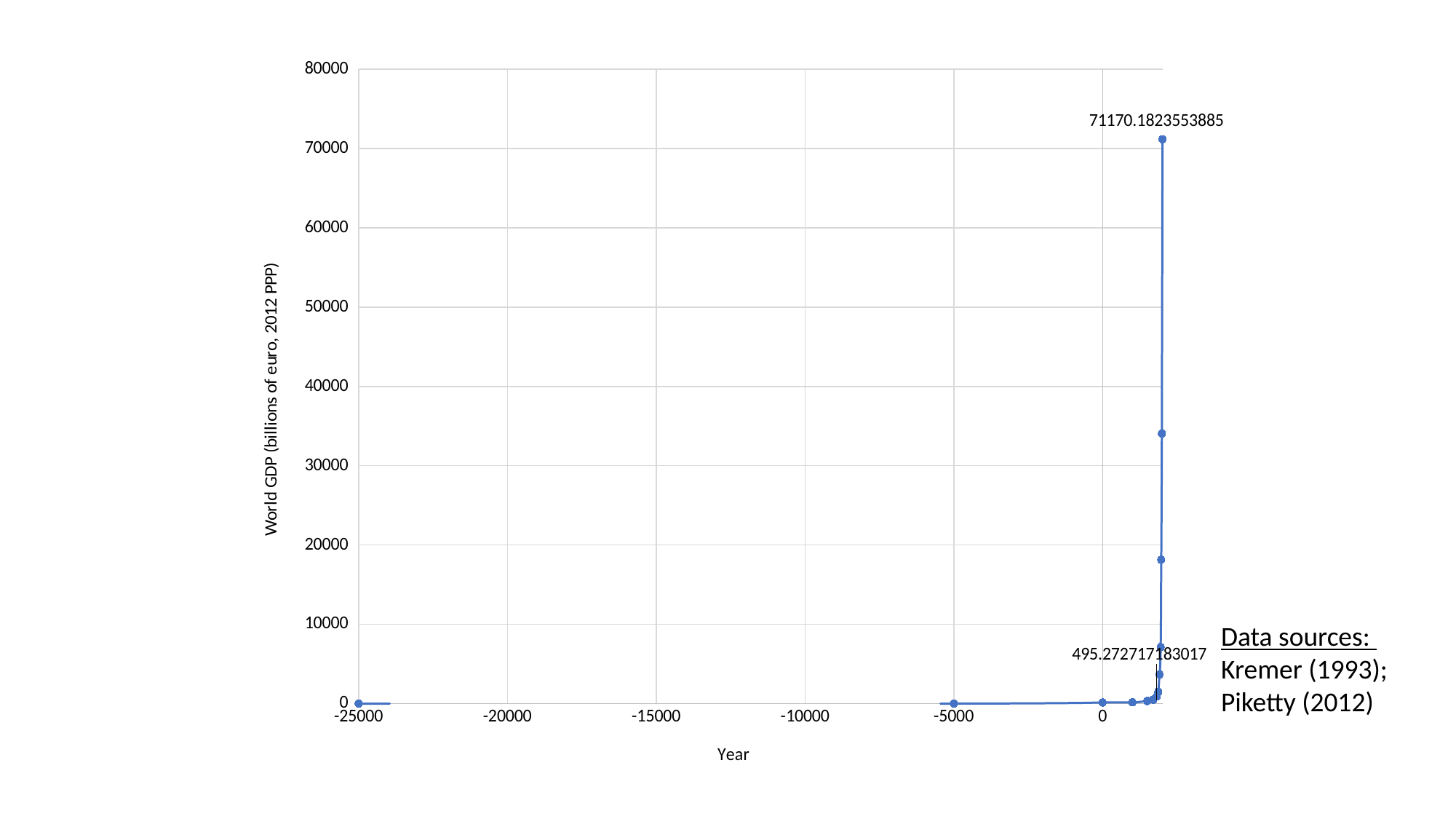
What kind of chart is shown on the slide? line chart Which of the two labelled values is larger, 71170.1823553885 or 495.272717183017? 71170.1823553885 Do the World GDP values rise or fall as the year increases along the x axis? rise Is the second-highest point on the chart greater or less than 30000? greater What is the smaller of the two data labels printed on the chart? 495.272717183017 What is the label of the y axis? World GDP (billions of euro, 2012 PPP) Is the third-highest point on the chart greater or less than 20000? less Is the value plotted at year -5000 greater or less than 10000? less What is the label of the x axis? Year What is the highest World GDP value labelled on the chart? 71170.1823553885